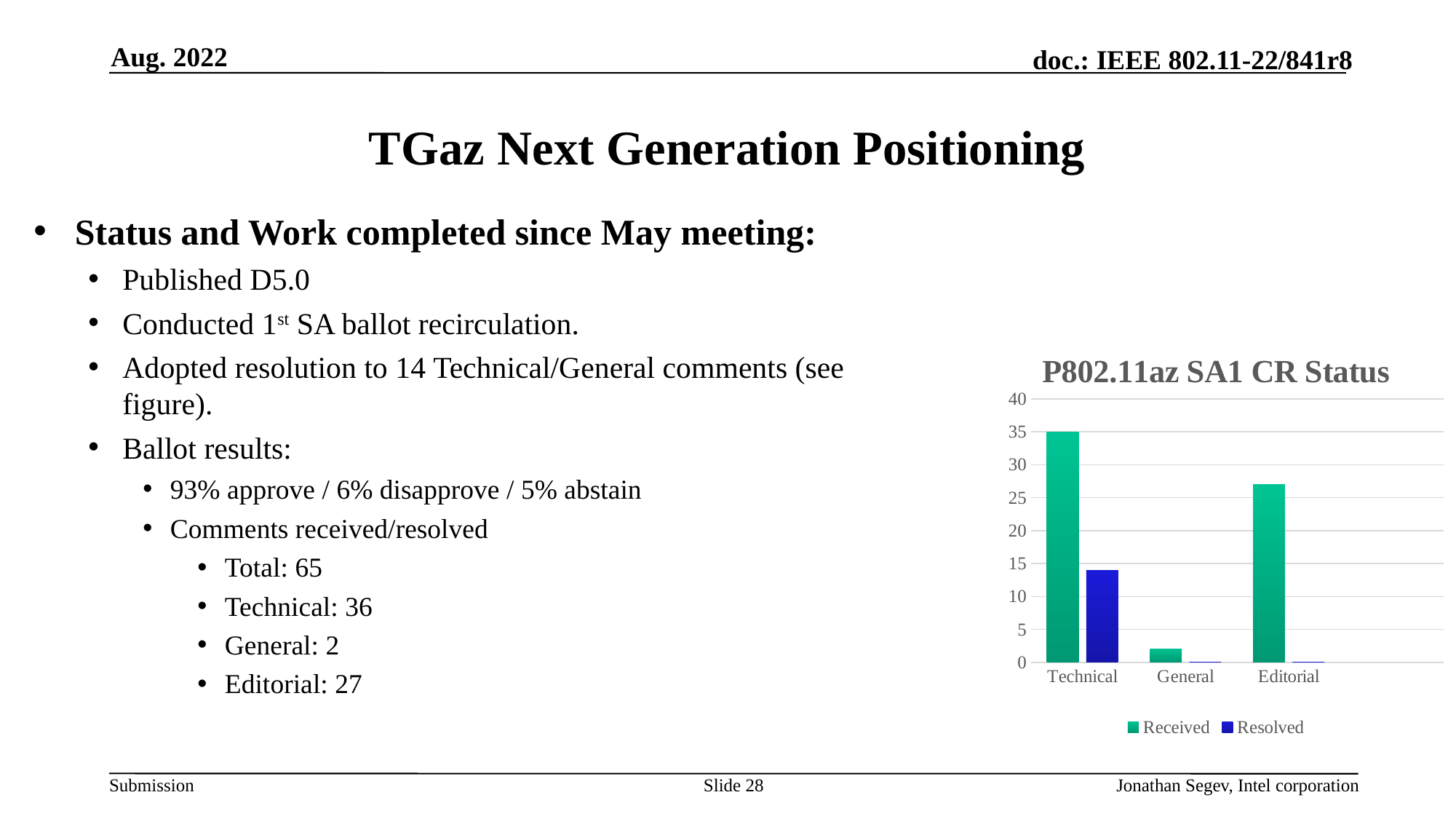
Which category has the highest Received value in the "P802.11az SA1 CR Status" chart? Technical How many categories are shown on the x axis of the "P802.11az SA1 CR Status" chart? 3 Which category has the lowest Received value in the "P802.11az SA1 CR Status" chart? General Is the Received value for Editorial greater or less than 25? greater Is the Resolved value for Technical greater or less than 20? less Is the Received value for General greater or less than 5? less Which category has the highest Resolved value in the "P802.11az SA1 CR Status" chart? Technical What kind of chart is shown under the title "P802.11az SA1 CR Status"? bar chart Which is larger in the "P802.11az SA1 CR Status" chart: the Received value for Technical or the Received value for Editorial? Technical What is the title of the chart on the slide? P802.11az SA1 CR Status How many series does the legend of the "P802.11az SA1 CR Status" chart list? 2